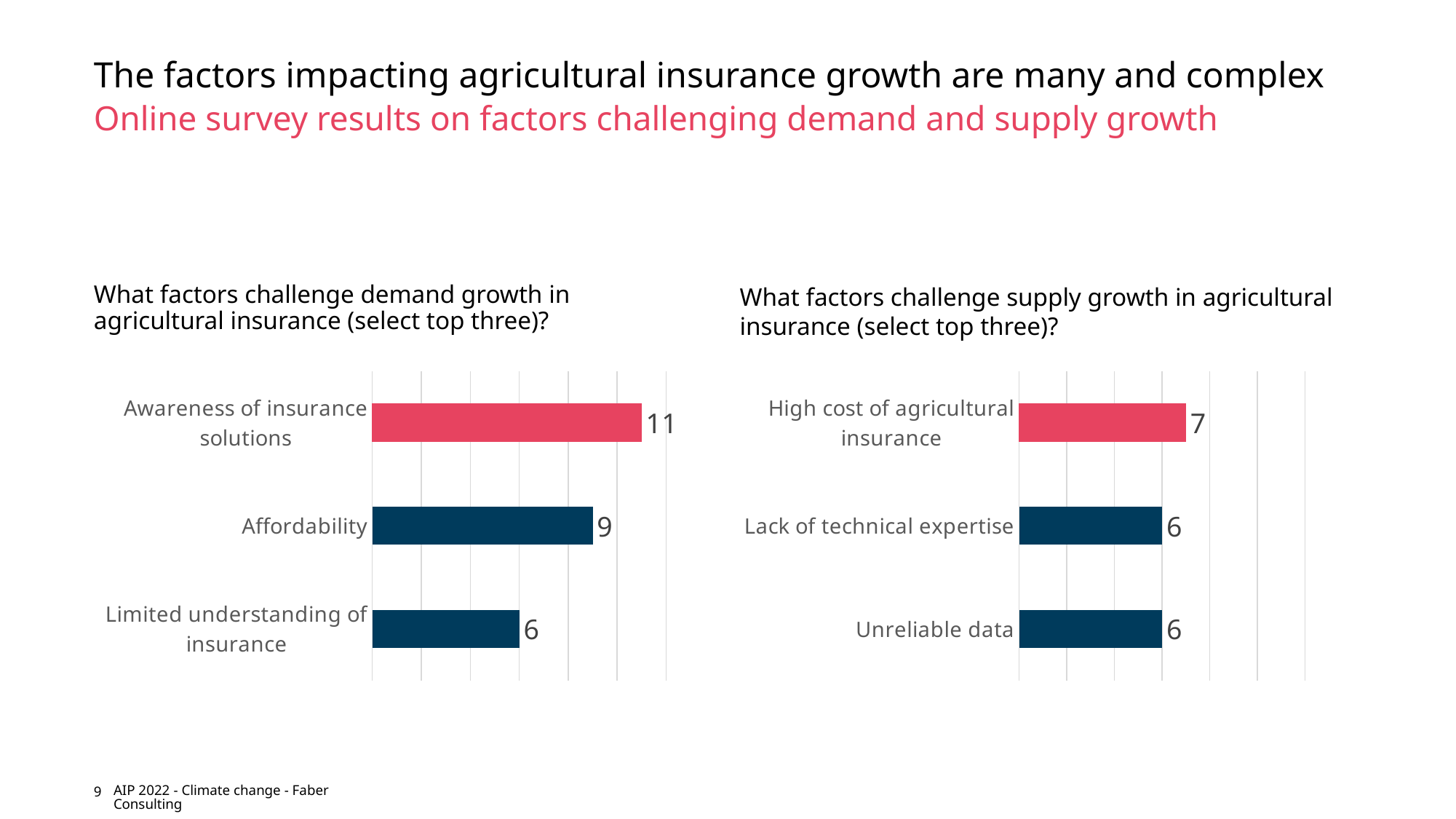
In the left chart on demand growth factors, what is the value for Affordability? 9 In the left chart on demand growth factors, which factor has the lowest value? Limited understanding of insurance In the left chart on demand growth factors, what is the value for Limited understanding of insurance? 6 In the left chart on demand growth factors, what is the value for Awareness of insurance solutions? 11 How many factors are shown in the right chart on supply growth factors? 3 In the left chart on demand growth factors, what is the difference between Awareness of insurance solutions and Affordability? 2 In the right chart on supply growth factors, which factor has the highest value? High cost of agricultural insurance In the right chart on supply growth factors, what is the value for High cost of agricultural insurance? 7 In the right chart on supply growth factors, what is the difference between High cost of agricultural insurance and Unreliable data? 1 In the left chart on demand growth factors, which factor has the highest value? Awareness of insurance solutions In the right chart on supply growth factors, what is the value for Lack of technical expertise? 6 What type of chart is the left chart on demand growth factors? Bar chart